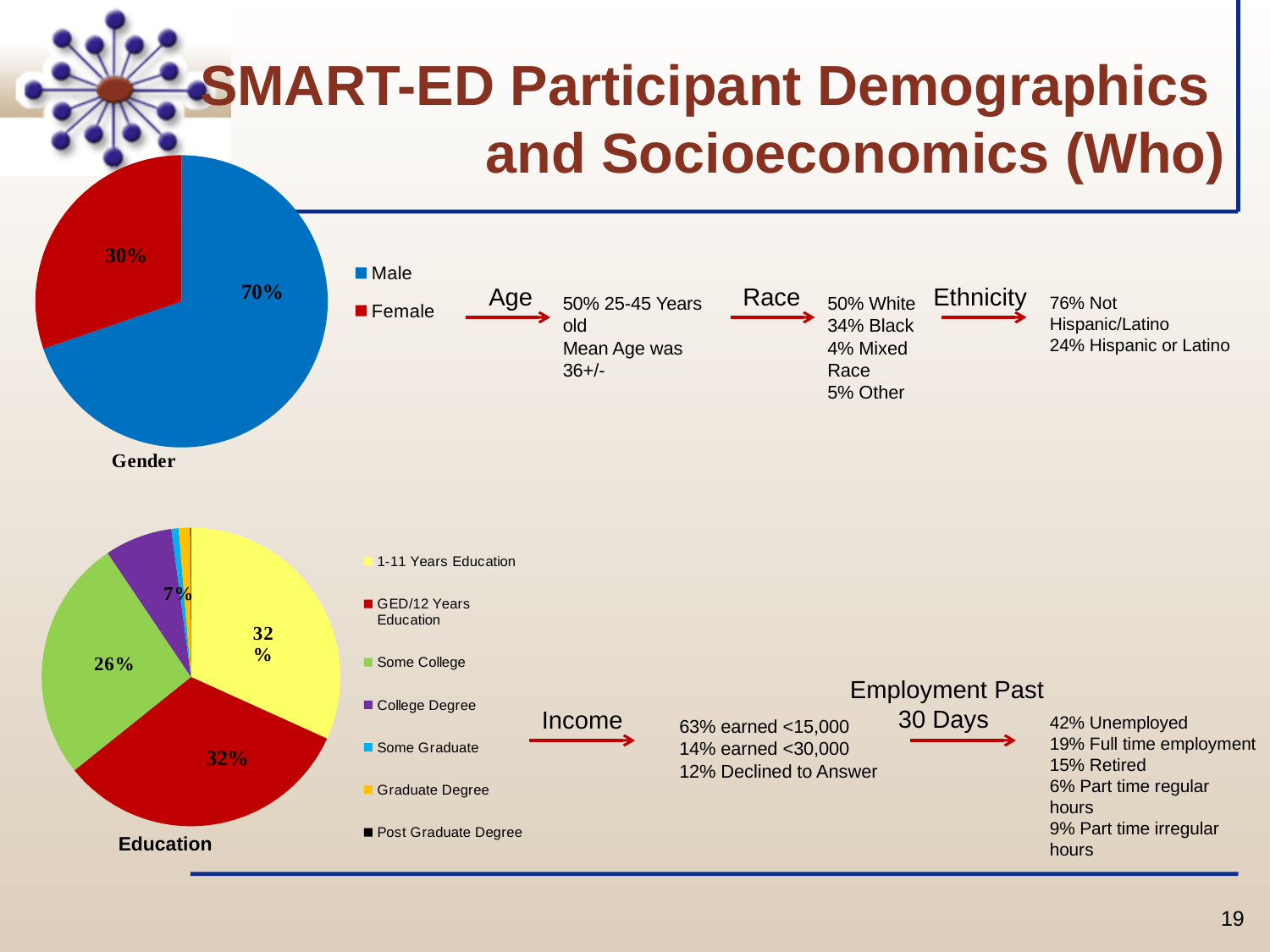
In the Education pie chart, what percentage of participants have a College Degree? 7% In the Education pie chart, what percentage of participants have Some College? 26% How many categories does the legend of the Education pie chart list? 7 In the Gender pie chart, what percentage of participants are Female? 30% In the Education pie chart, what percentage of participants have GED/12 Years Education? 32% In the Gender pie chart, what is the difference in percentage points between Male and Female? 40 In the Gender pie chart, which category has the larger share? Male How many entries does the legend of the Gender pie chart list? 2 In the Gender pie chart, what percentage of participants are Male? 70% In the Education pie chart, which is larger: Some College or College Degree? Some College In the Education pie chart, what colour is the Some College slice? Green What type of chart is the Gender chart? Pie chart